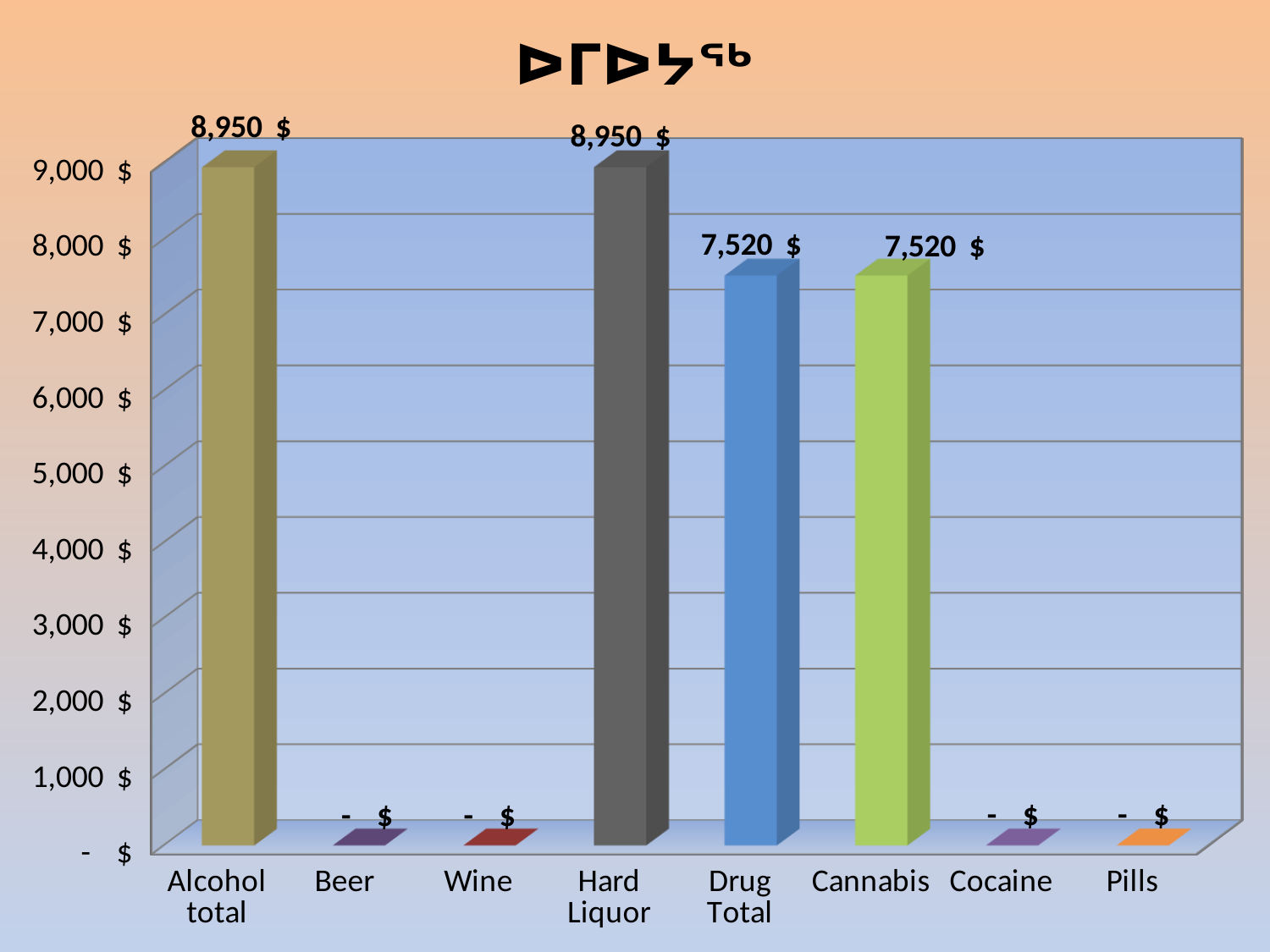
Is the value for Drug Total greater or less than 8,000 $? less Which is larger, the value for Hard Liquor or the value for Cannabis? Hard Liquor What is the value shown for Beer? - $ What is the value for Alcohol total? 8,950 $ What is the value for Cannabis? 7,520 $ What is the value for Hard Liquor? 8,950 $ Which is larger, the value for Alcohol total or the value for Drug Total? Alcohol total How many categories are shown on the x axis? 8 What kind of chart is shown on the slide? bar chart Is the value for Cannabis greater or less than 7,000 $? greater What is the difference between the value for Alcohol total and the value for Drug Total? 1,430 $ What is the value for Drug Total? 7,520 $